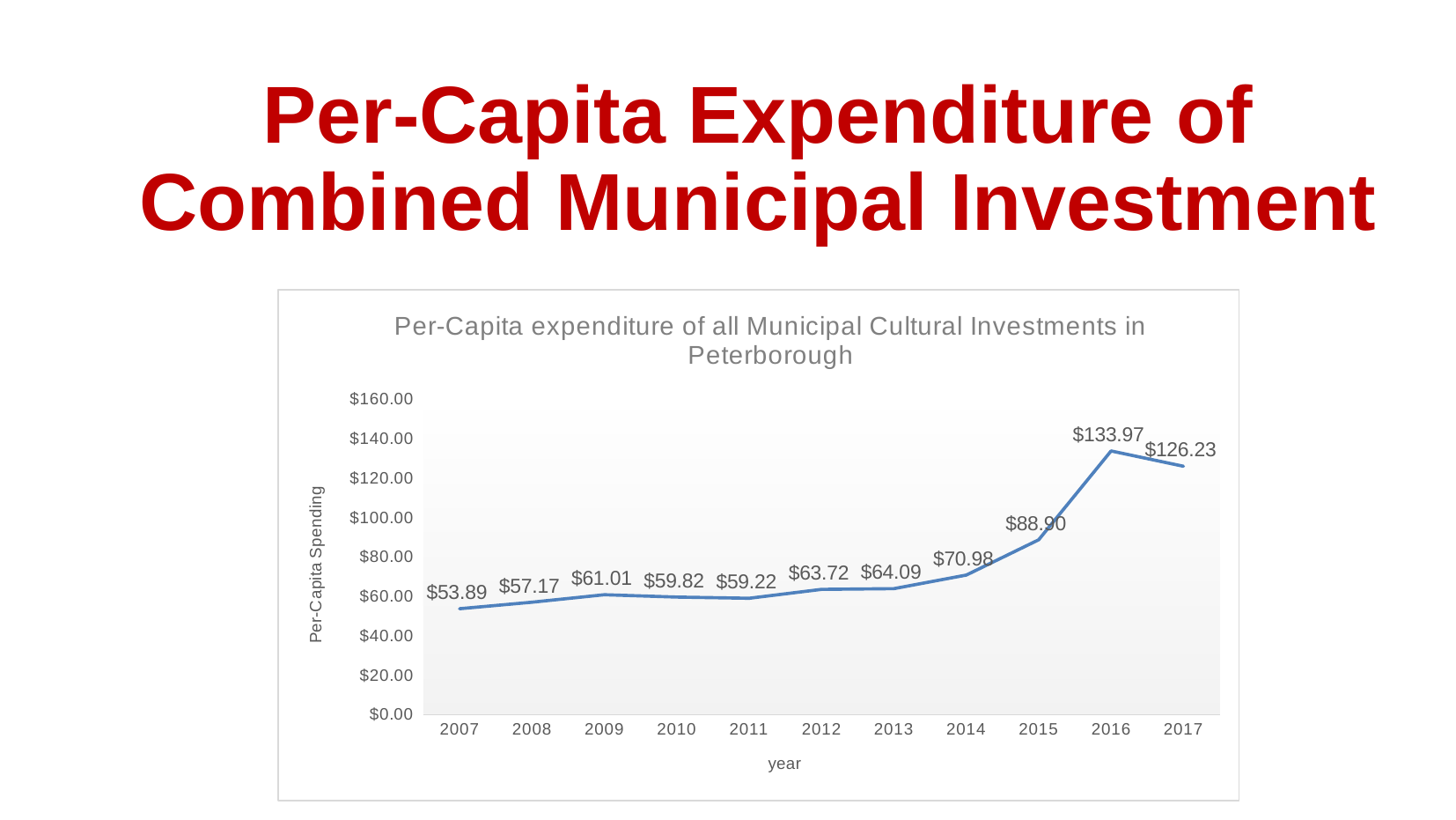
Is the per-capita spending for 2015 greater or less than $100.00? less What kind of chart is shown on the slide? line chart How many years are plotted on the x axis? 11 Which year has the lowest per-capita spending? 2007 What is the label of the y axis? Per-Capita Spending Does per-capita spending rise or fall from 2014 to 2016? rise What is the per-capita spending value for 2014? $70.98 What is the per-capita spending value for 2007? $53.89 Which year has the highest per-capita spending? 2016 What is the difference between the per-capita spending in 2016 and 2017? $7.74 What is the per-capita spending value for 2016? $133.97 Which year has higher per-capita spending, 2015 or 2017? 2017